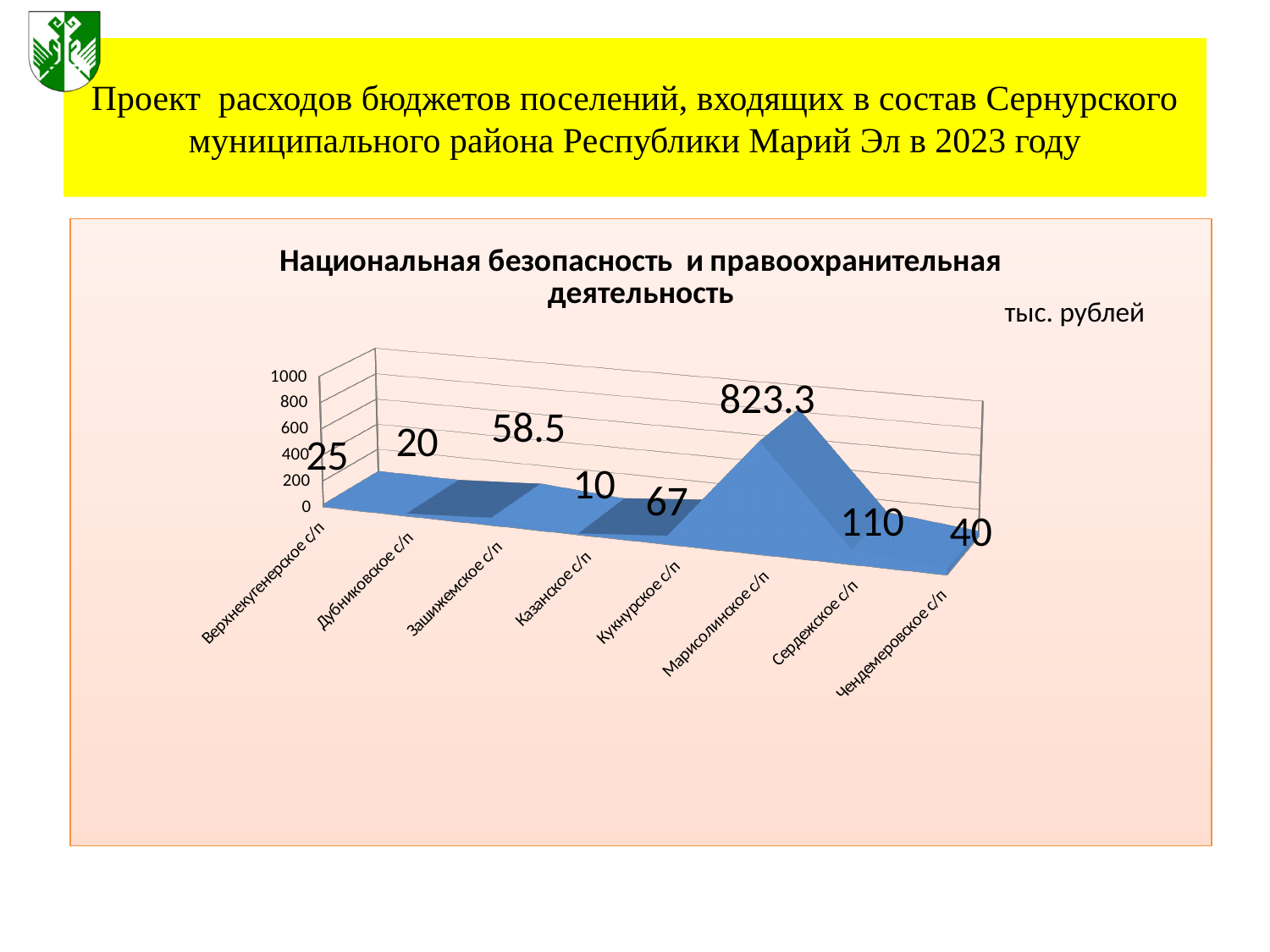
What kind of chart is shown? area chart What is the value for Марисолинское с/п? 823.3 What is the value for Сердежское с/п? 110 Which is larger, the value for Кукнурское с/п or the value for Чендемеровское с/п? Кукнурское с/п Is the value for Марисолинское с/п greater or less than 800? greater What is the value for Казанское с/п? 10 What is the title of the chart? Национальная безопасность и правоохранительная деятельность What is the value for Зашижемское с/п? 58.5 Which settlement has the lowest value? Казанское с/п What is the difference between the values for Марисолинское с/п and Сердежское с/п? 713.3 Which settlement has the highest value? Марисолинское с/п How many settlements are shown on the x axis? 8